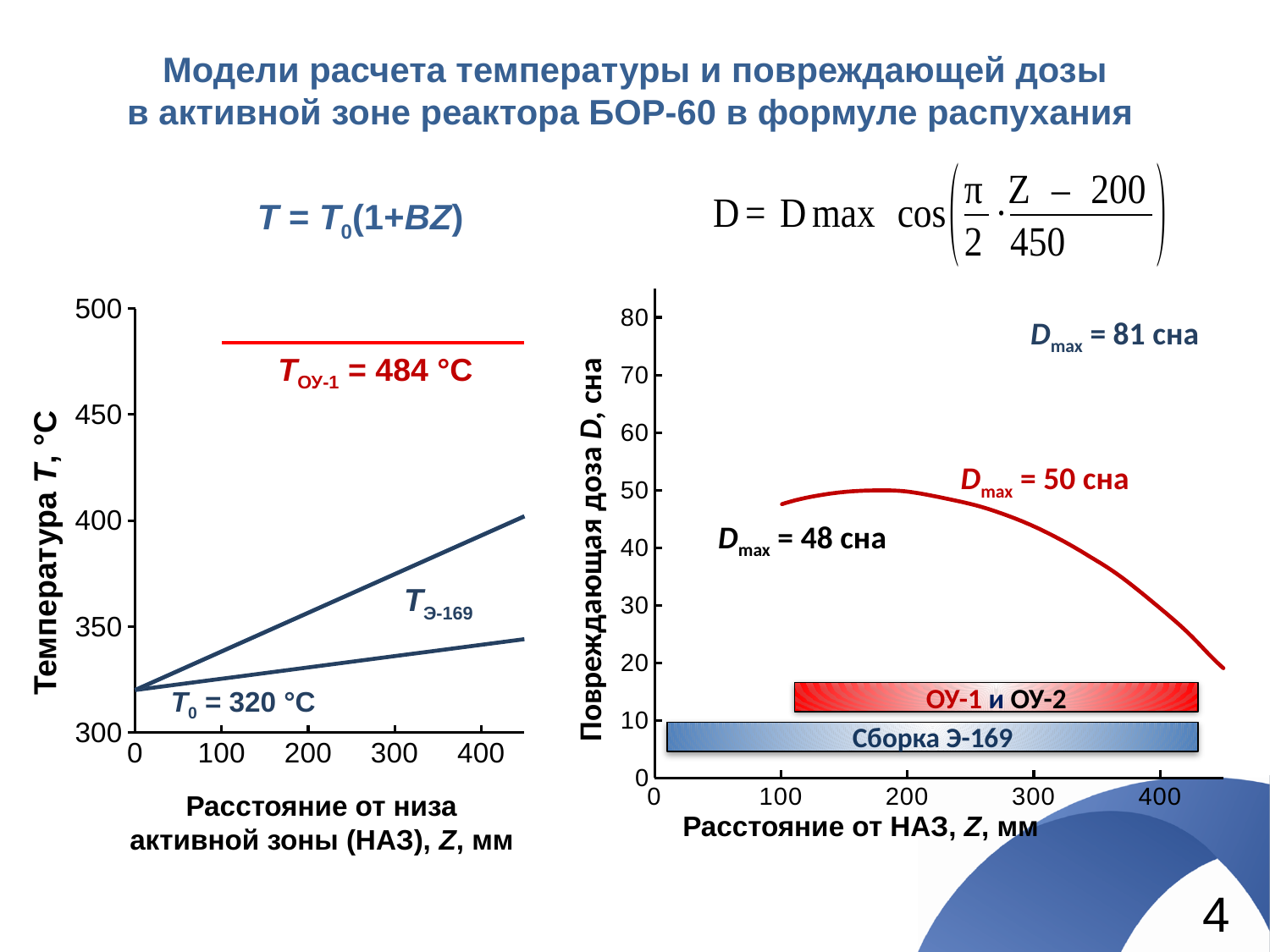
On the right dose chart, what D_max value is labelled next to the red curve? 50 сна On the left temperature chart, what is the label of the vertical axis? Температура T, °C On the left temperature chart, is the T_ОУ-1 line greater or less than 450 °C? greater On the left temperature chart, what is the value of T_0? 320 °C On the right dose chart, what is the largest D_max value shown? 81 сна On the left temperature chart, what is the difference between T_ОУ-1 and T_0? 164 °C On the right dose chart, what is the difference between D_max = 81 сна and D_max = 50 сна? 31 сна What kind of chart is the left chart (Температура T, °C vs Z)? line chart On the left temperature chart, does the T_Э-169 line rise or fall as Z increases? rises On the right dose chart, is the value of the red curve at Z = 100 mm greater or less than 40? greater On the right dose chart, does the red curve rise or fall between Z = 200 and Z = 450 mm? falls On the left temperature chart, what is the value of T_ОУ-1? 484 °C